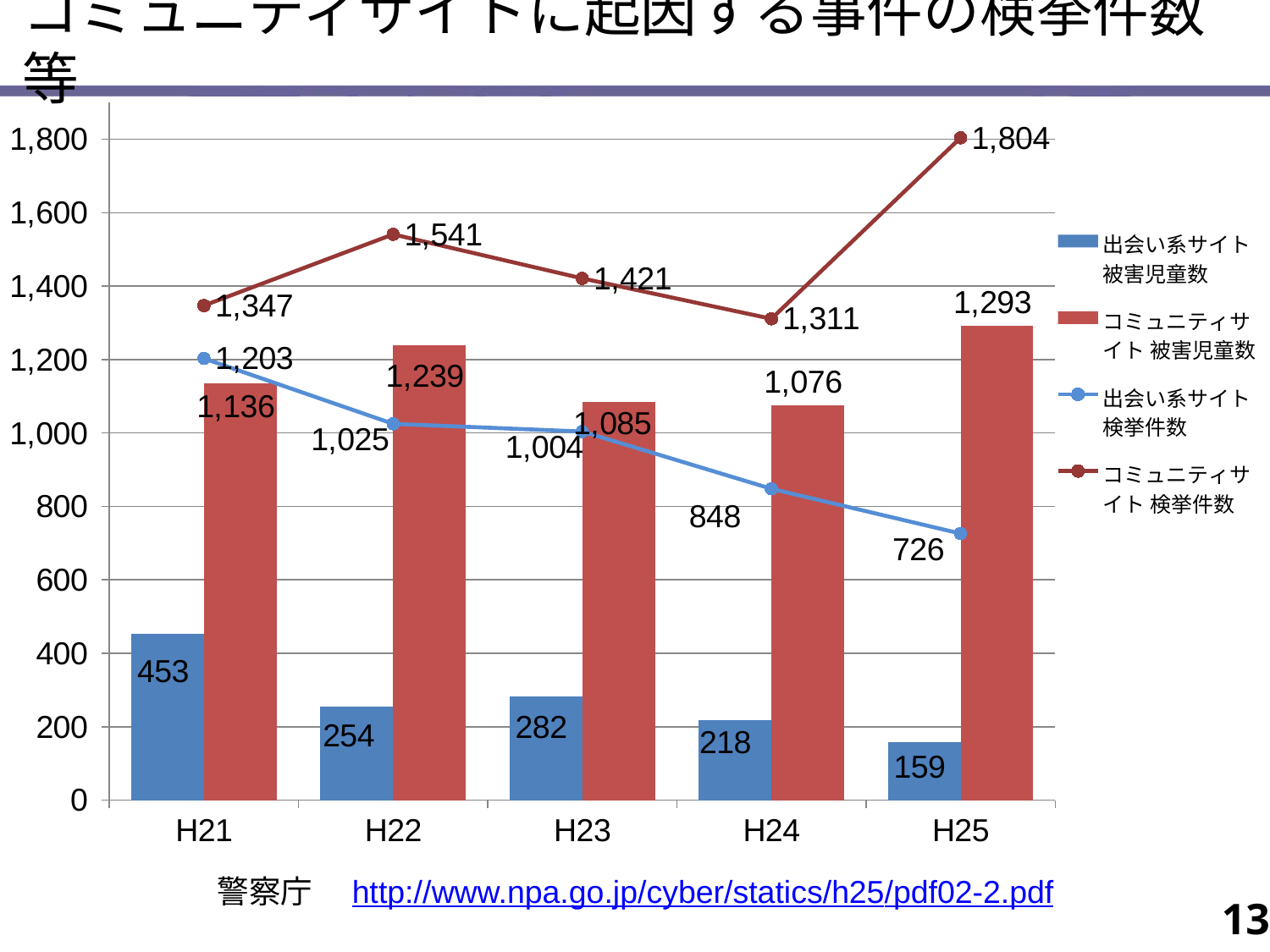
Which series is drawn as a blue line with markers? 出会い系サイト 検挙件数 How many years are shown on the x axis? 5 What is the difference between コミュニティサイト 検挙件数 in H25 and H24? 493 How many series does the legend list? 4 What is the value of コミュニティサイト 被害児童数 for H25? 1,293 What is the value of 出会い系サイト 検挙件数 for H24? 848 In which year is コミュニティサイト 検挙件数 highest? H25 Does 出会い系サイト 検挙件数 rise or fall from H21 to H25? fall Which is larger in H23: コミュニティサイト 被害児童数 or 出会い系サイト 検挙件数? コミュニティサイト 被害児童数 What is the value of コミュニティサイト 検挙件数 for H22? 1,541 In which year is 出会い系サイト 被害児童数 lowest? H25 What is the value of 出会い系サイト 被害児童数 for H21? 453